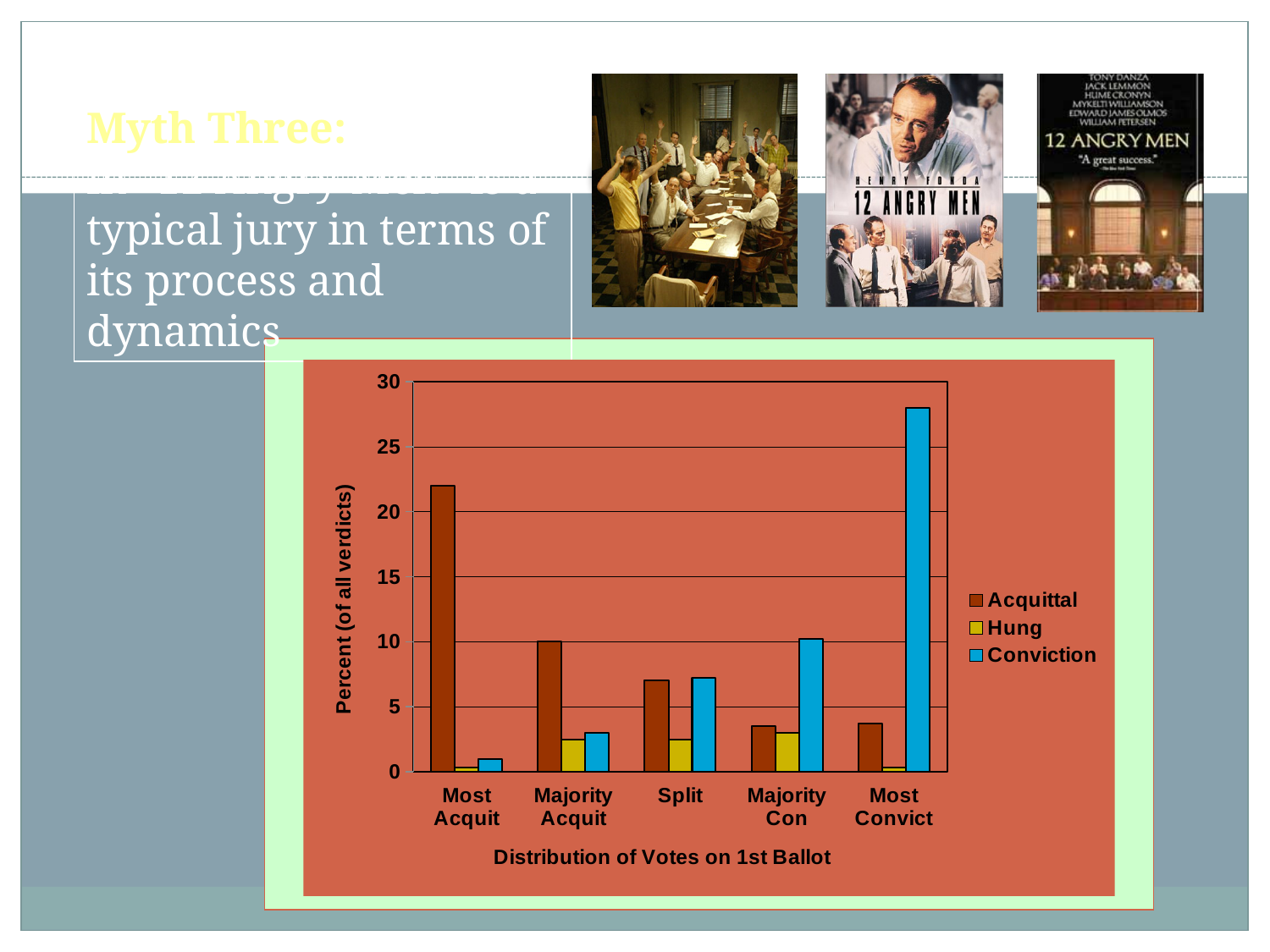
How many series does the chart's legend list? 3 Do the Conviction values rise or fall moving from Most Acquit to Most Convict along the x axis? rise Is the Acquittal value for Most Acquit greater or less than 20? greater How many categories are shown along the x axis of the chart? 5 What kind of chart is shown on the slide? bar chart Which category has the highest Acquittal value? Most Acquit Is the Conviction value for Most Convict greater or less than 25? greater Which category has the highest Conviction value? Most Convict For the Majority Con category, which is larger: Acquittal or Conviction? Conviction Which category has the lowest Conviction value? Most Acquit What is the title of the chart's x axis? Distribution of Votes on 1st Ballot For the Most Acquit category, which is larger: Acquittal or Conviction? Acquittal